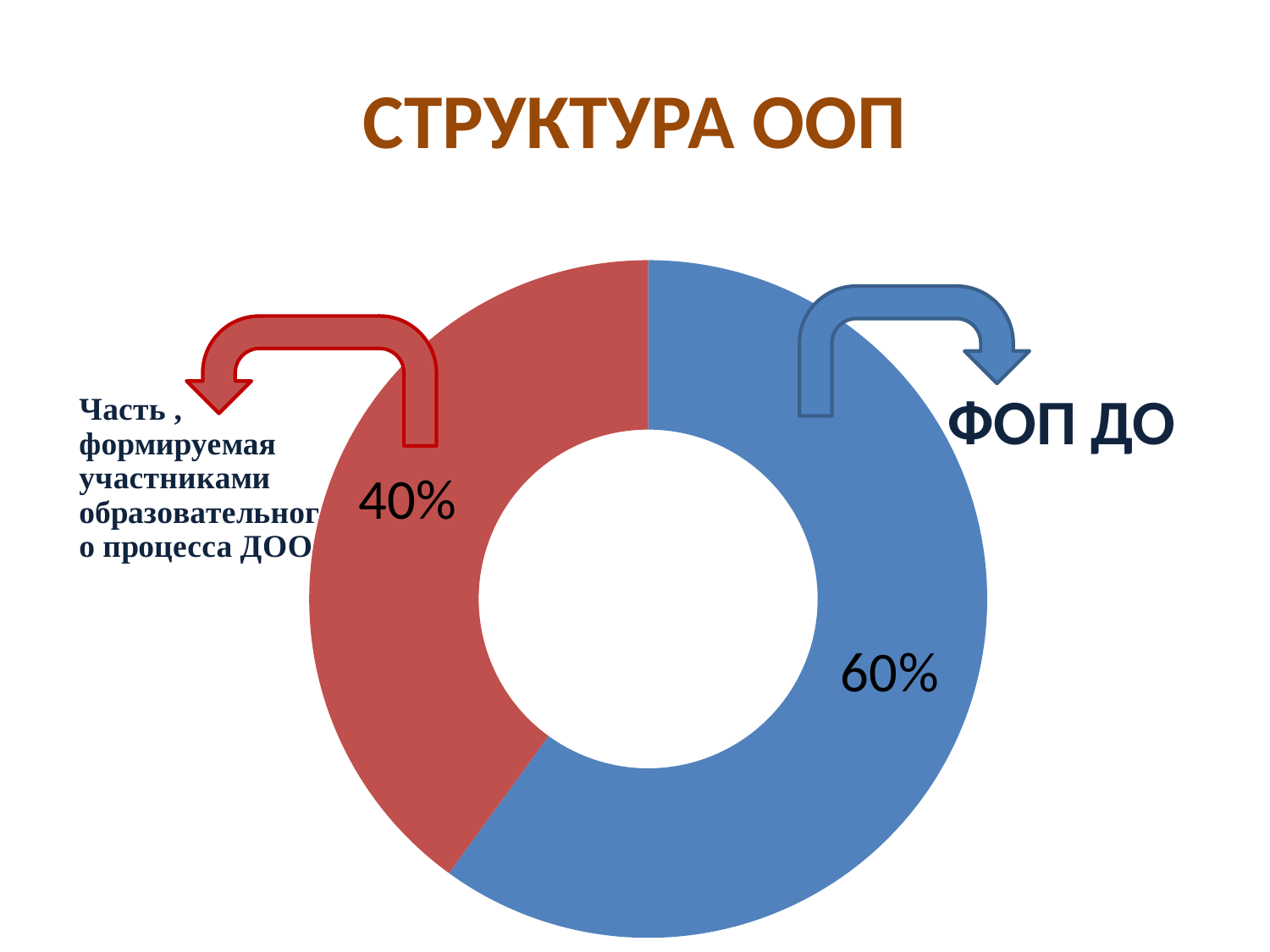
What is the total of the two segments shown in the chart? 100% What share of the chart does the segment labelled 'Часть, формируемая участниками образовательного процесса ДОО' represent? 40% How many segments does the chart have? 2 What share of the chart does the ФОП ДО segment represent? 60% What is the title of the slide containing the chart? СТРУКТУРА ООП What is the difference in percentage points between the ФОП ДО segment and the part formed by participants of the educational process? 20% Which is larger: the ФОП ДО segment or the part formed by participants of the educational process? ФОП ДО Which segment is the smallest in the chart? Часть, формируемая участниками образовательного процесса ДОО Which segment is the largest in the chart? ФОП ДО What kind of chart is shown on the slide? Doughnut chart What colour is the ФОП ДО segment? Blue